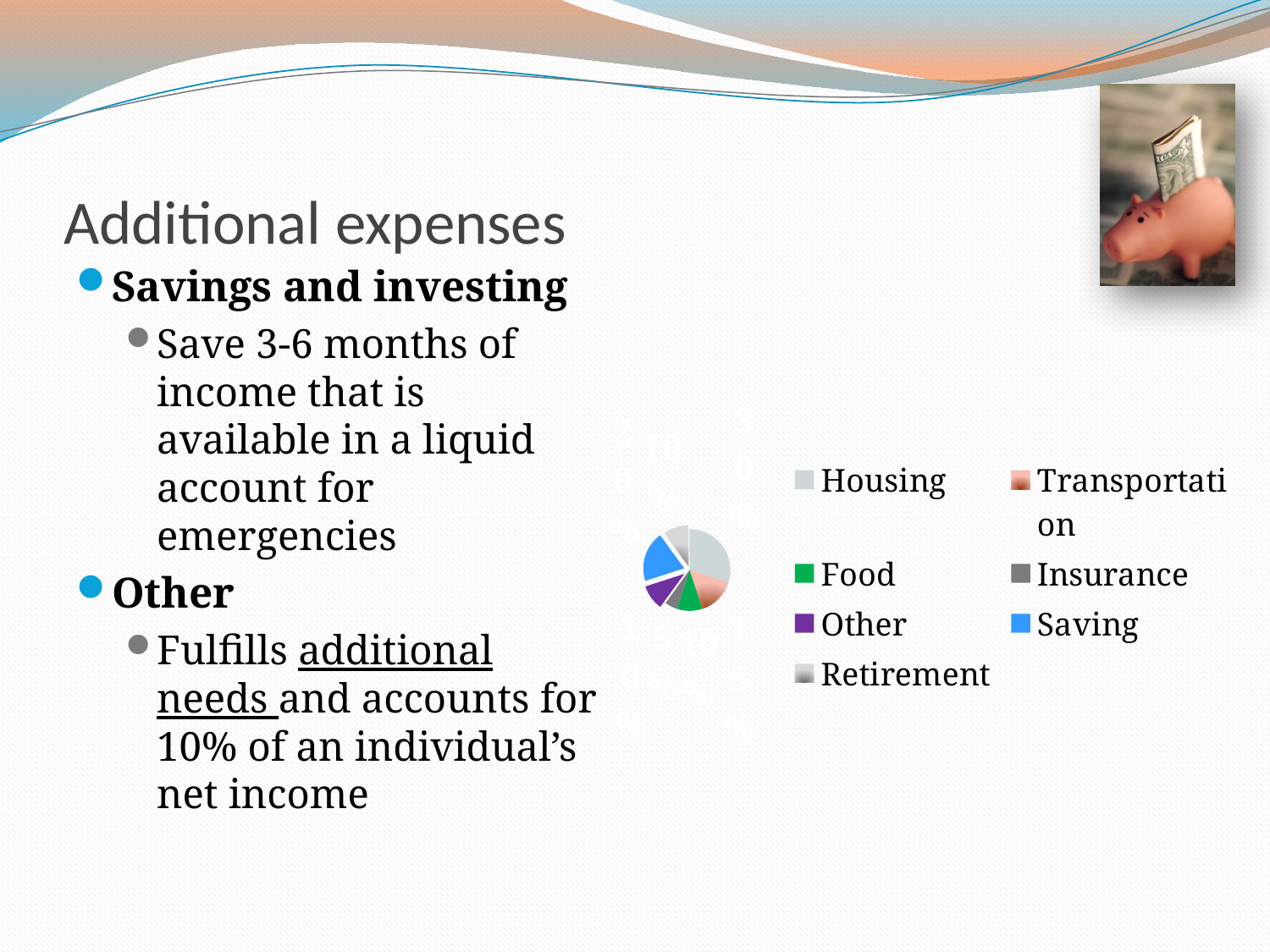
What colour represents Saving in the pie chart legend? blue What kind of chart is shown on the slide? pie chart Which category has the largest slice in the pie chart? Housing Which slice is larger in the pie chart, Housing or Insurance? Housing How many slices does the pie chart have? 7 Which category is shown in green in the pie chart? Food Which slice is larger in the pie chart, Housing or Food? Housing How many categories does the legend of the pie chart list? 7